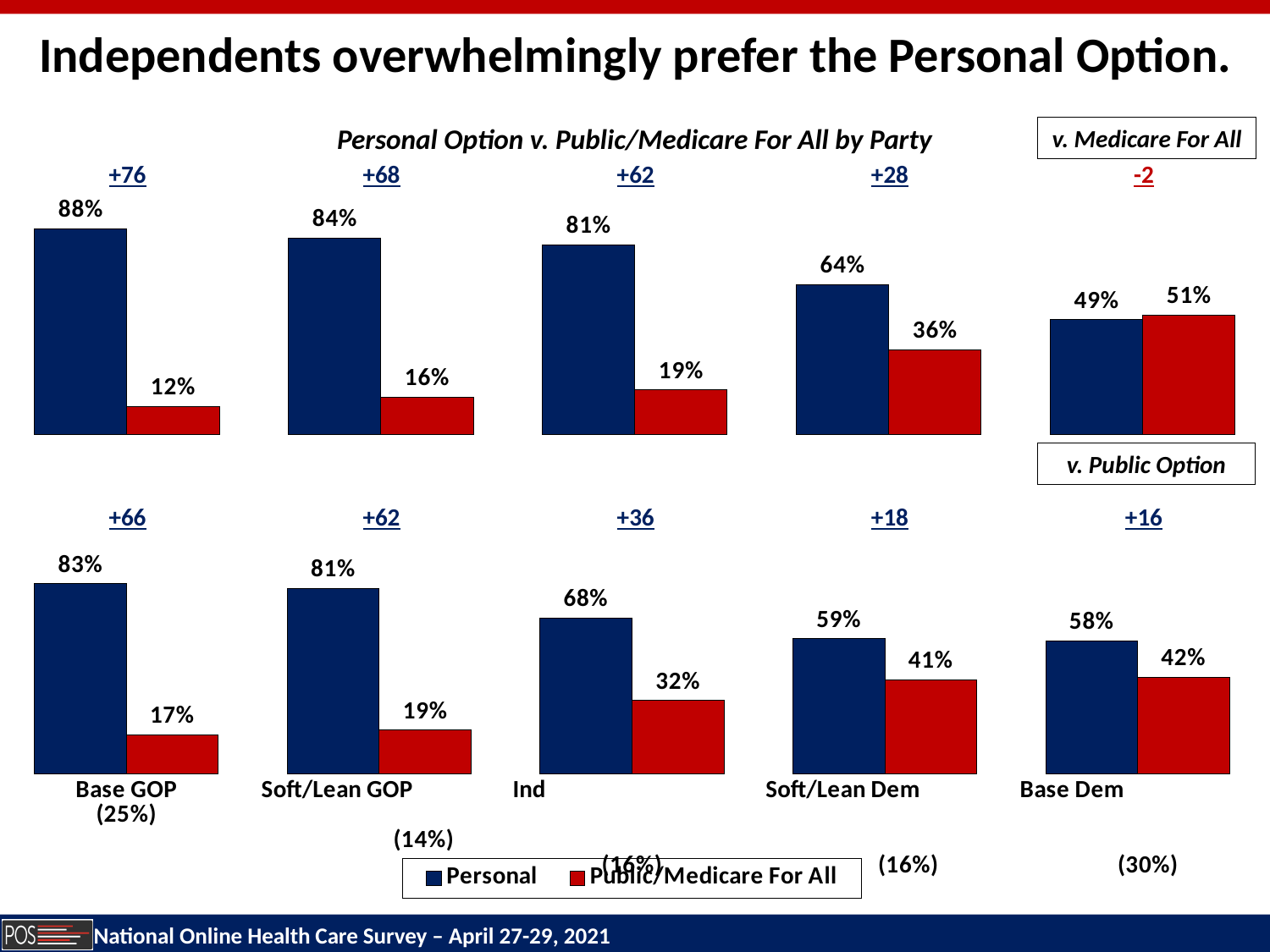
How many series does the legend list? 2 What kind of chart is used on this slide? Bar chart What is the title shown above the top chart? Personal Option v. Public/Medicare For All by Party In the bottom chart (v. Public Option), do the Personal Option values rise or fall moving from Base GOP to Base Dem? Fall How many party groups are shown in the bottom chart (v. Public Option)? 5 In the top chart (v. Medicare For All), what percentage of Independents prefer the Personal Option? 81% In the top chart (v. Medicare For All), what is the difference between the Personal and Medicare For All values for Soft/Lean Dem? 28 In the bottom chart (v. Public Option), what is the Personal Option value for Soft/Lean GOP? 81% In the bottom chart (v. Public Option), which party group has the lowest Personal Option value? Base Dem In the top chart (v. Medicare For All), which party group has the highest Personal Option value? Base GOP In the bottom chart (v. Public Option), what percentage of Base Dem respondents prefer the Public Option? 42% In the top chart (v. Medicare For All), which is larger for Base Dem: the Personal value or the Medicare For All value? Medicare For All